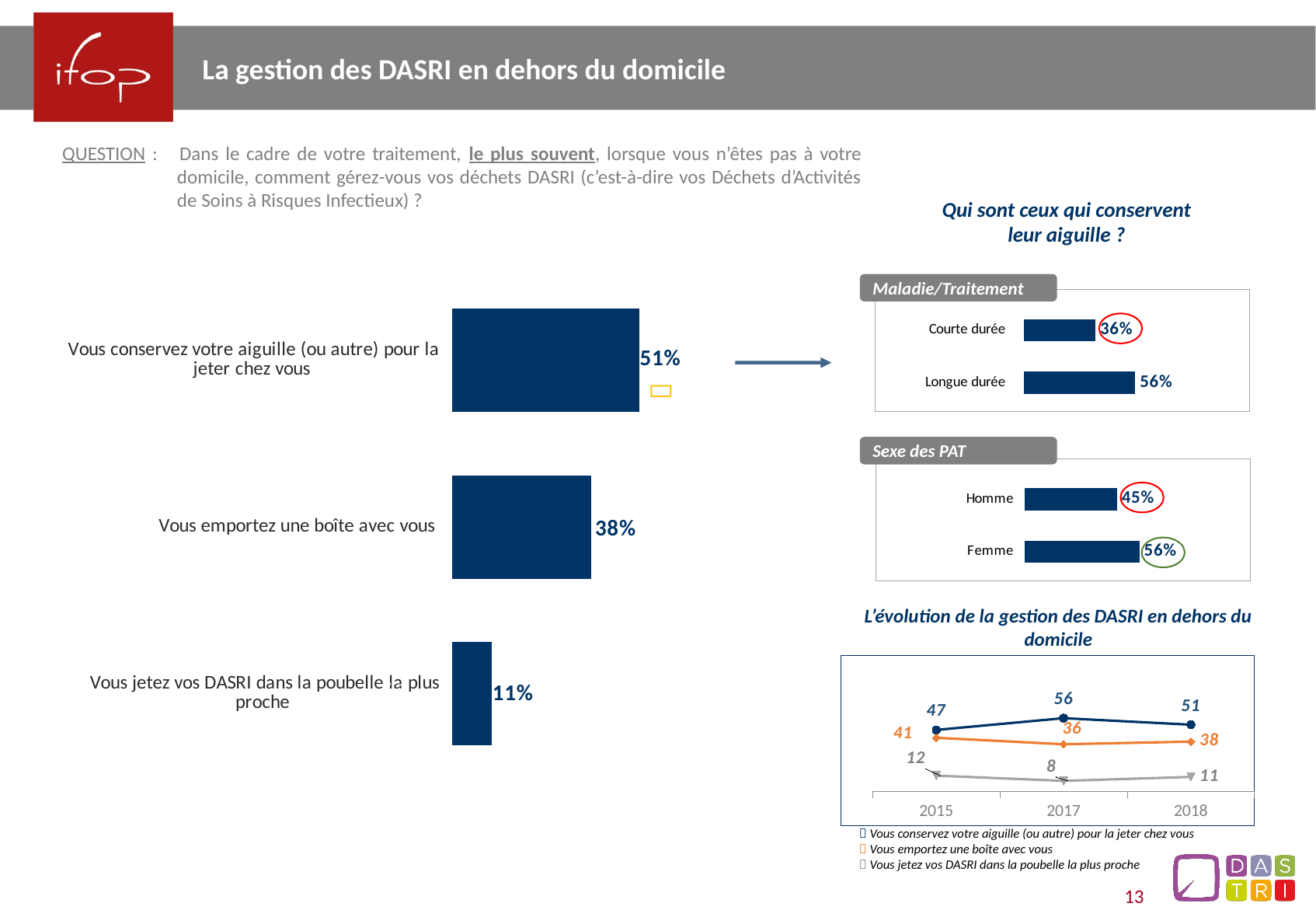
In the line chart "L'évolution de la gestion des DASRI en dehors du domicile", what is the value for "Vous conservez votre aiguille" in 2017? 56 In the "Sexe des PAT" chart, what is the difference between "Femme" and "Homme"? 11% In the line chart "L'évolution de la gestion des DASRI en dehors du domicile", how many series does the legend list? 3 In the main bar chart on the left, which category has the highest value? Vous conservez votre aiguille (ou autre) pour la jeter chez vous In the main bar chart on the left, what is the value for "Vous emportez une boîte avec vous"? 38% In the main bar chart on the left, which category has the lowest value? Vous jetez vos DASRI dans la poubelle la plus proche How many categories does the main bar chart on the left show? 3 What kind of chart is "L'évolution de la gestion des DASRI en dehors du domicile"? Line chart In the "Maladie/Traitement" chart, which is larger, "Courte durée" or "Longue durée"? Longue durée In the "Maladie/Traitement" chart, what is the value for "Courte durée"? 36% In the main bar chart on the left, what is the difference between the values for "Vous conservez votre aiguille" and "Vous emportez une boîte avec vous"? 13% In the "Sexe des PAT" chart, what is the value for "Homme"? 45%